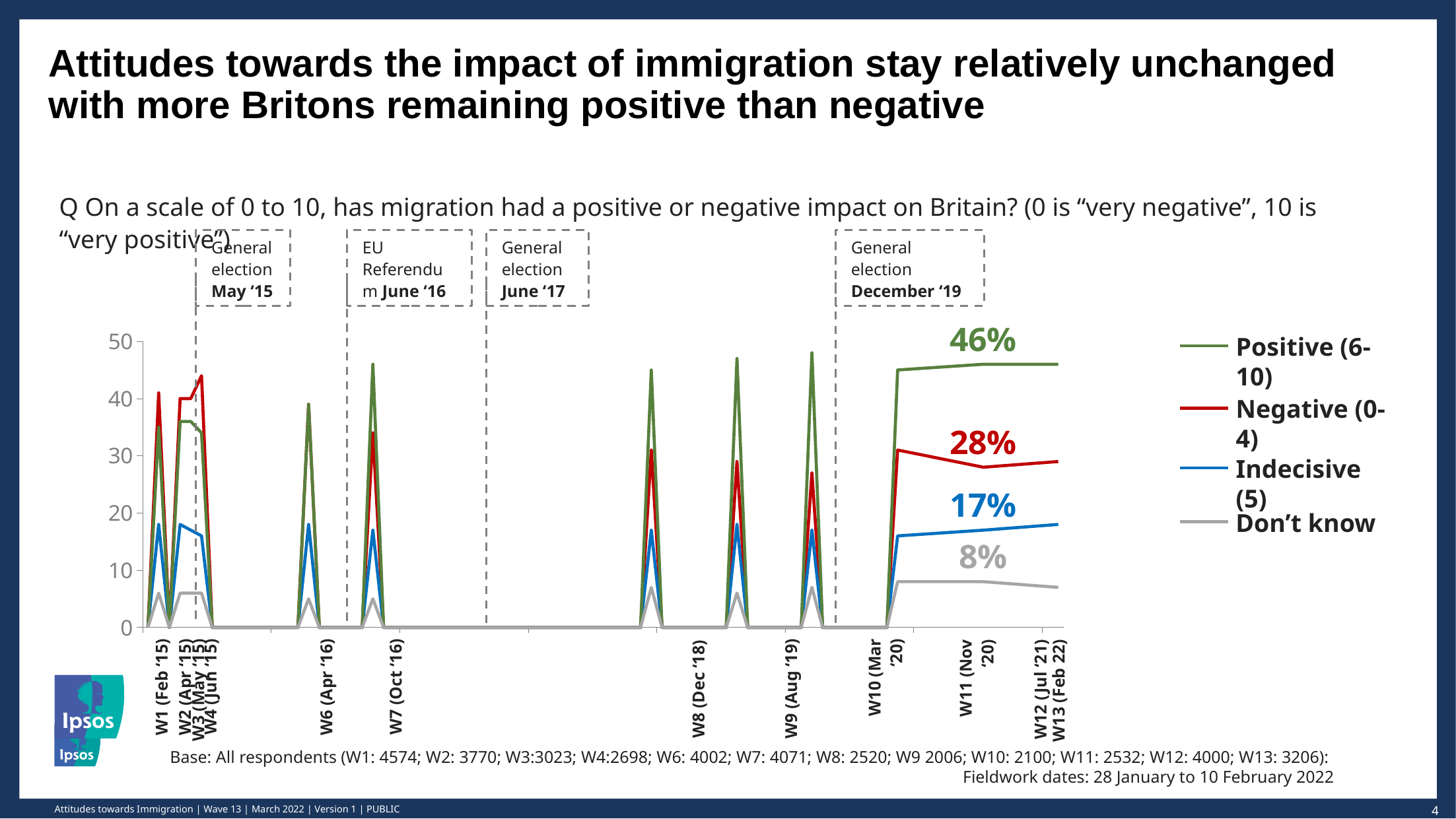
Is the value for Positive (6-10) at W1 (Feb '15) greater or less than 30? greater Is the value for Don't know at W1 (Feb '15) greater or less than 10? less Which series has the highest value at W13 (Feb 22)? Positive (6-10) Which series has the lowest value at W13 (Feb 22)? Don't know How many series does the legend list? 4 What kind of chart is shown on the slide? Line chart At W13 (Feb 22), which is larger: Indecisive (5) or Don't know? Indecisive (5) What is the value for Positive (6-10) at W13 (Feb 22)? 46%